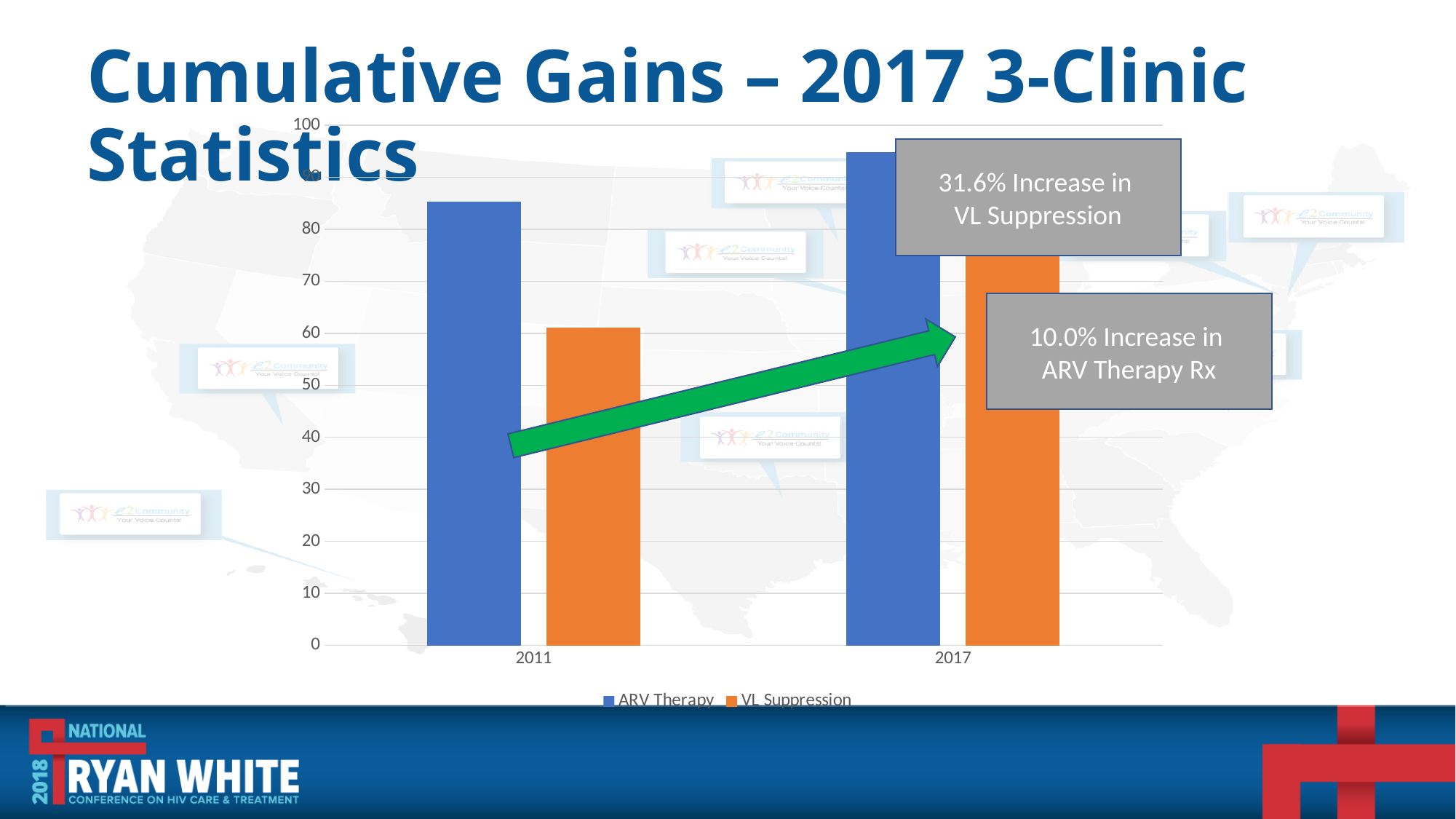
Is the value for VL Suppression in 2011 greater or less than 70? less According to the callout box on the chart, what is the percentage increase in VL Suppression? 31.6% Does the ARV Therapy value rise or fall from 2011 to 2017? Rise Which bar in the chart is the lowest? VL Suppression in 2011 Is the value for VL Suppression in 2017 greater or less than 70? greater For VL Suppression, which year has the larger value: 2011 or 2017? 2017 Is the value for ARV Therapy in 2011 greater or less than 80? greater In 2011, which is larger: ARV Therapy or VL Suppression? ARV Therapy How many year categories are shown on the x axis of the chart? 2 What kind of chart is shown on the slide? Bar chart How many series does the chart legend list? 2